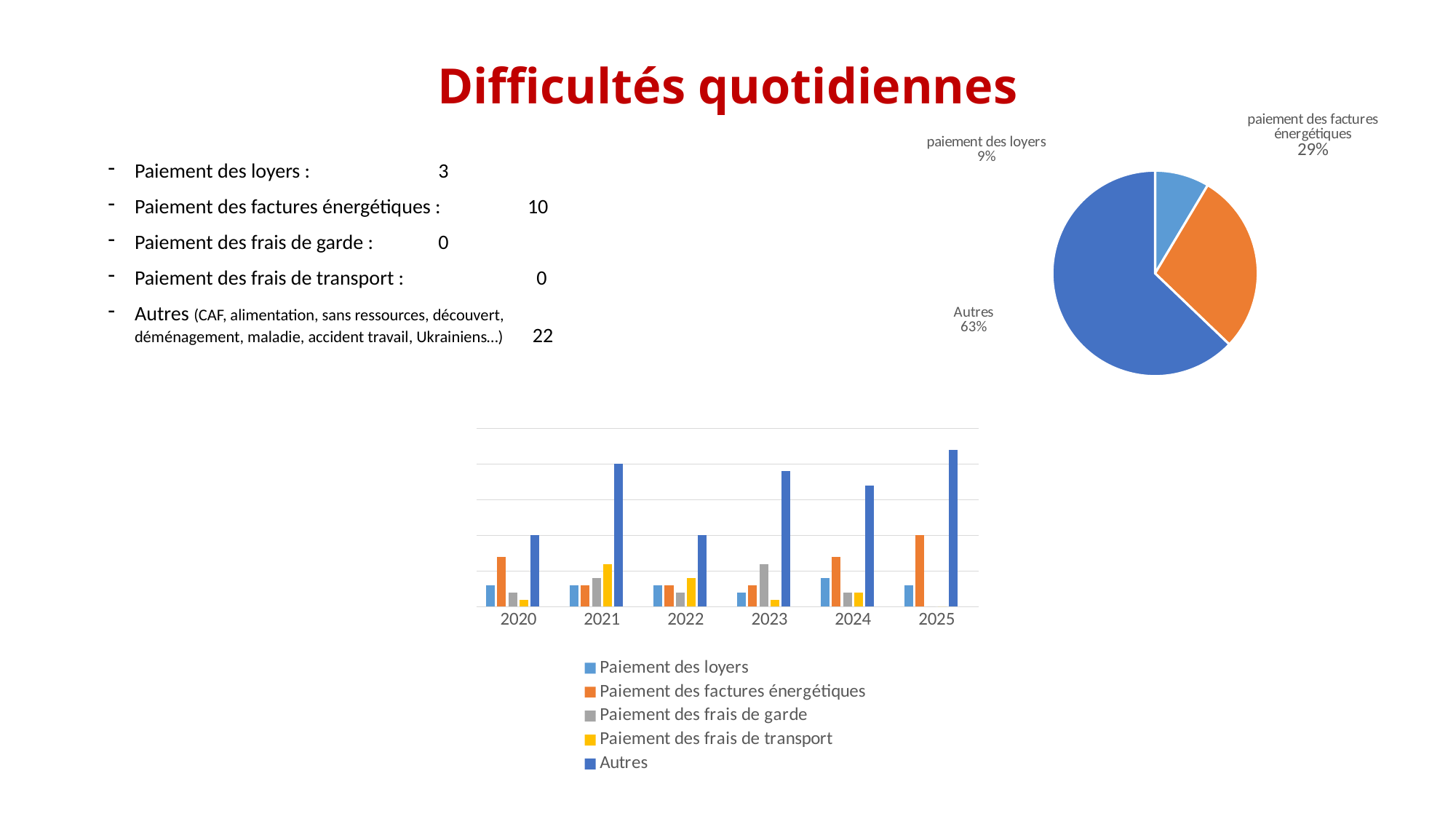
What kind of chart is the chart at the bottom of the slide? bar chart On the pie chart, how many slices are there? 3 On the pie chart, how many percentage points larger is Autres than paiement des factures énergétiques? 34 On the pie chart, which slice is the smallest? paiement des loyers On the bar chart at the bottom, how many years are shown on the x axis? 6 On the bar chart at the bottom, in 2020, which is larger: Paiement des factures énergétiques or Paiement des loyers? Paiement des factures énergétiques On the pie chart, what share is shown for paiement des factures énergétiques? 29% On the pie chart, which slice is the largest? Autres On the pie chart, what share is shown for Autres? 63% On the bar chart at the bottom, how many series does the legend list? 5 On the bar chart at the bottom, in which year is the Paiement des frais de garde bar the tallest? 2023 On the bar chart at the bottom, in which year is the Autres bar the tallest? 2025